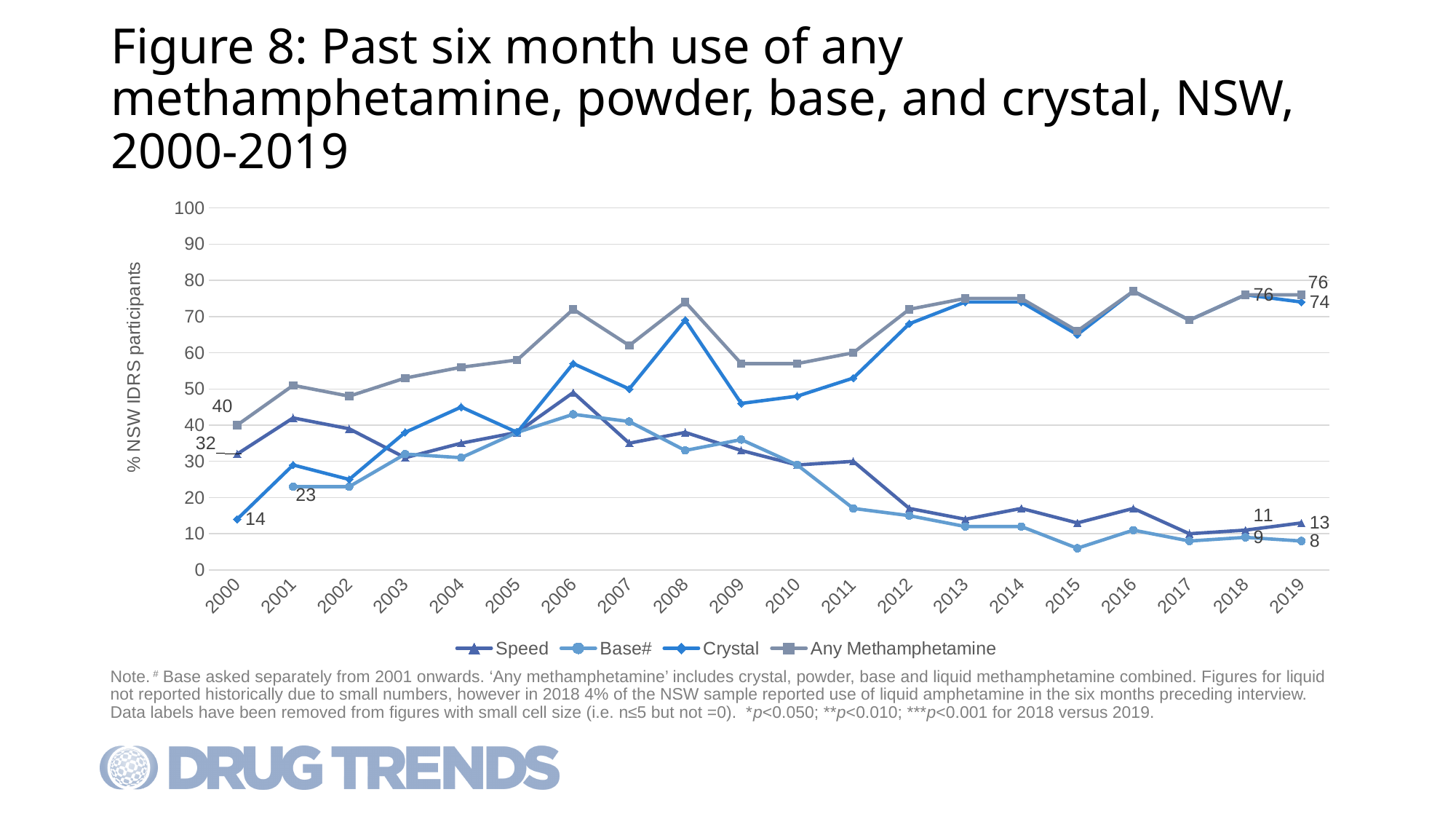
What is the value for Base# in 2001? 23 Is the value for Any Methamphetamine in 2016 greater or less than 70? greater What is the value for Any Methamphetamine in 2019? 76 In 2019, which is larger: the value for Speed or the value for Base#? Speed What is the difference between the Any Methamphetamine value and the Crystal value in 2019? 2 How many series does the legend list? 4 How many years are plotted along the x axis? 20 By how much did the Any Methamphetamine value change from 2000 to 2019? 36 What is the value for Crystal in 2019? 74 What kind of chart is shown on the slide? line chart What is the value for Speed in 2000? 32 What is the value for Speed in 2018? 11